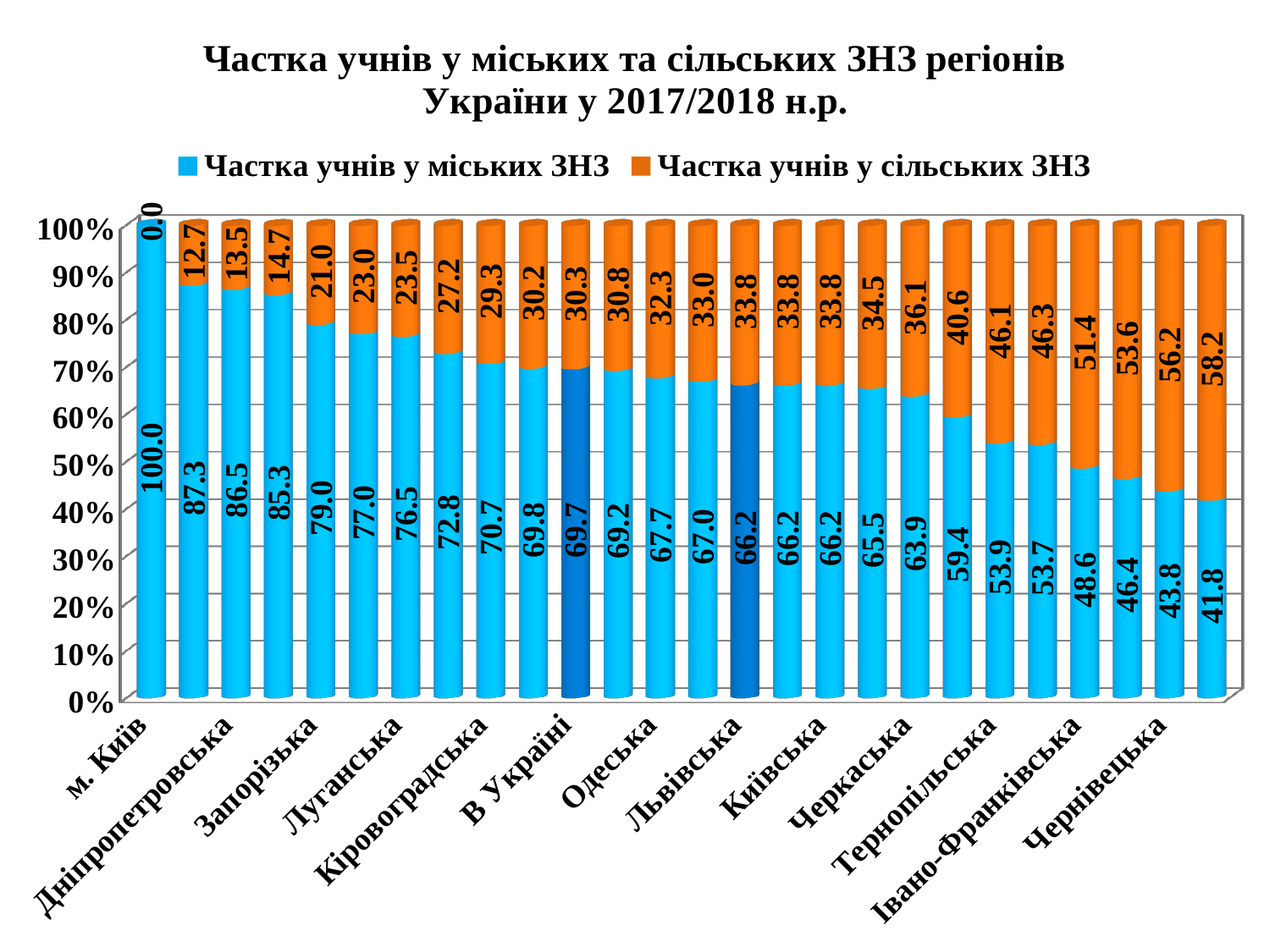
Does the 'Частка учнів у міських ЗНЗ' value rise or fall from left to right along the x axis? fall Which is larger, the 'Частка учнів у міських ЗНЗ' value for Одеська or for Івано-Франківська? Одеська How many bars (regions) are plotted in the chart? 26 What is the value of 'Частка учнів у сільських ЗНЗ' for Чернівецька? 56.2 What is the value of 'Частка учнів у міських ЗНЗ' for Тернопільська? 53.9 What is the value of 'Частка учнів у міських ЗНЗ' for м. Київ? 100.0 What kind of chart is shown on the slide? bar chart Which region has the highest value for 'Частка учнів у міських ЗНЗ'? м. Київ How many series does the legend list? 2 What is the difference between the 'Частка учнів у міських ЗНЗ' values for Київська and Чернівецька? 22.4 What is the value of 'Частка учнів у міських ЗНЗ' for В Україні? 69.7 What is the value of 'Частка учнів у сільських ЗНЗ' for Дніпропетровська? 13.5